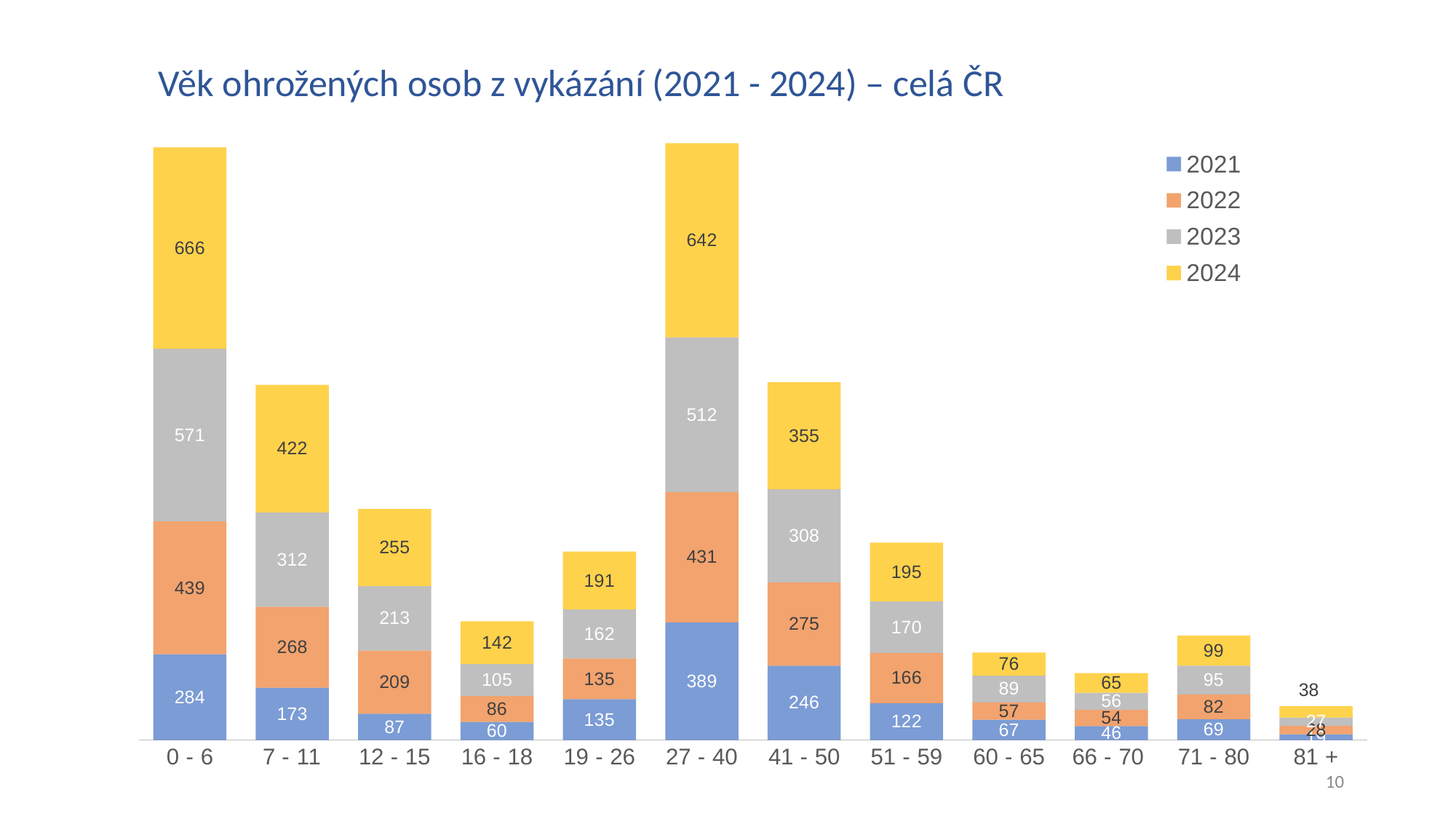
What is the 2024 value for the 0 - 6 age group? 666 What is the 2023 value for the 41 - 50 age group? 308 Which age group has the highest 2024 value? 0 - 6 How many age categories are shown on the x axis? 12 Which age group has the lowest 2023 value? 81 + What kind of chart is shown on the slide? stacked bar chart What is the difference between the 2024 values for the 0 - 6 and 27 - 40 age groups? 24 How many series does the legend list? 4 What is the total of the stacked bar for the 16 - 18 age group? 393 Which is larger, the 2022 value for 7 - 11 or the 2022 value for 41 - 50? 41 - 50 What is the 2022 value for the 12 - 15 age group? 209 What is the 2021 value for the 27 - 40 age group? 389